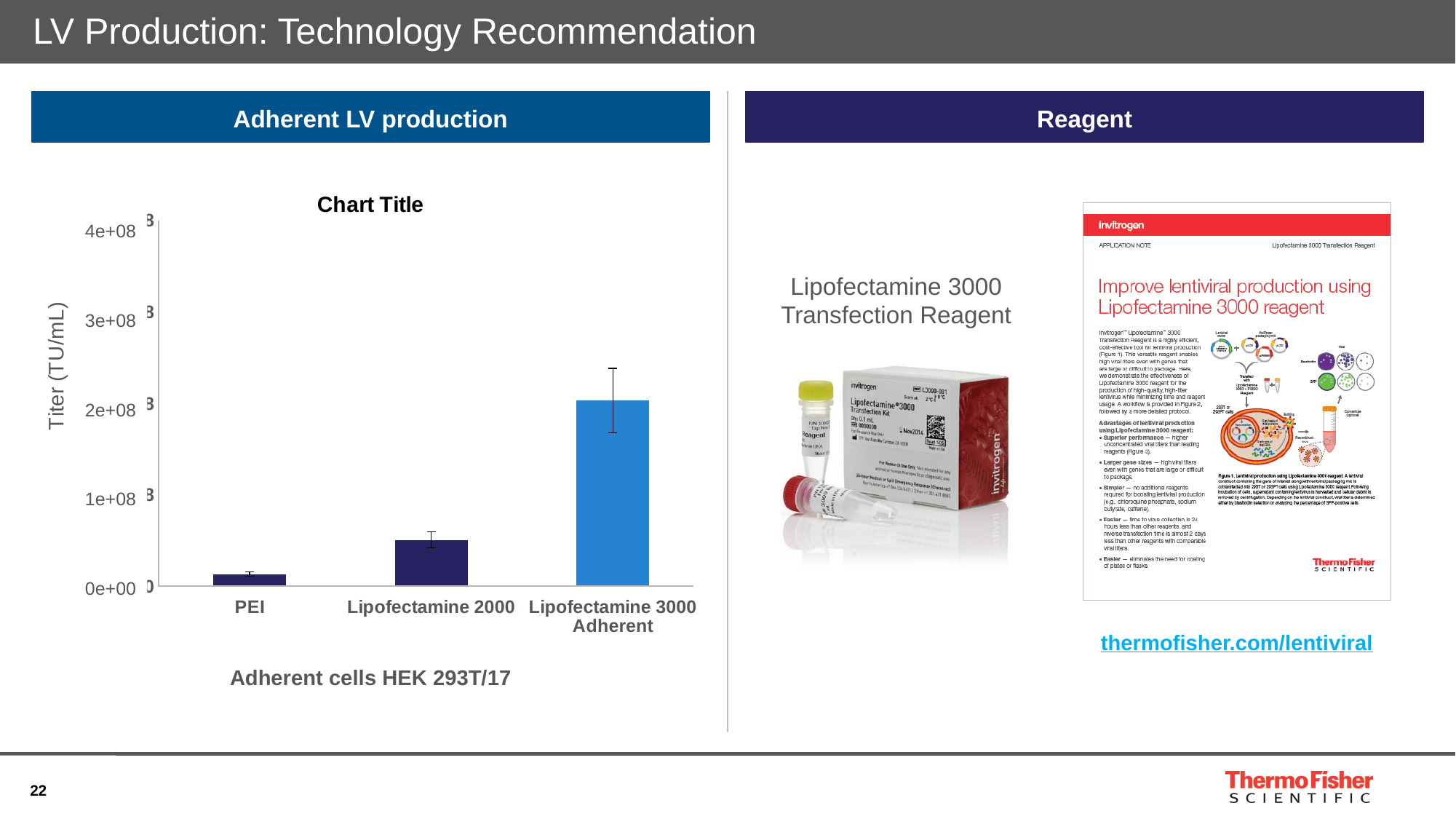
Which category has the lowest titer in the chart? PEI What cell line is named in the caption below the chart? Adherent cells HEK 293T/17 How many categories are plotted on the x axis of the chart? 3 Which category has the highest titer in the chart? Lipofectamine 3000 Adherent Is the titer for Lipofectamine 2000 greater or less than 1e+08? less Is the titer for PEI greater or less than 1e+08? less Do the bar values rise or fall from left to right across the x axis? rise Which has a higher titer, PEI or Lipofectamine 2000? Lipofectamine 2000 Is the titer for Lipofectamine 3000 Adherent greater or less than 1e+08? greater What kind of chart is shown on the slide? bar chart Which has a higher titer, Lipofectamine 2000 or Lipofectamine 3000 Adherent? Lipofectamine 3000 Adherent What is the label on the y axis of the chart? Titer (TU/mL)